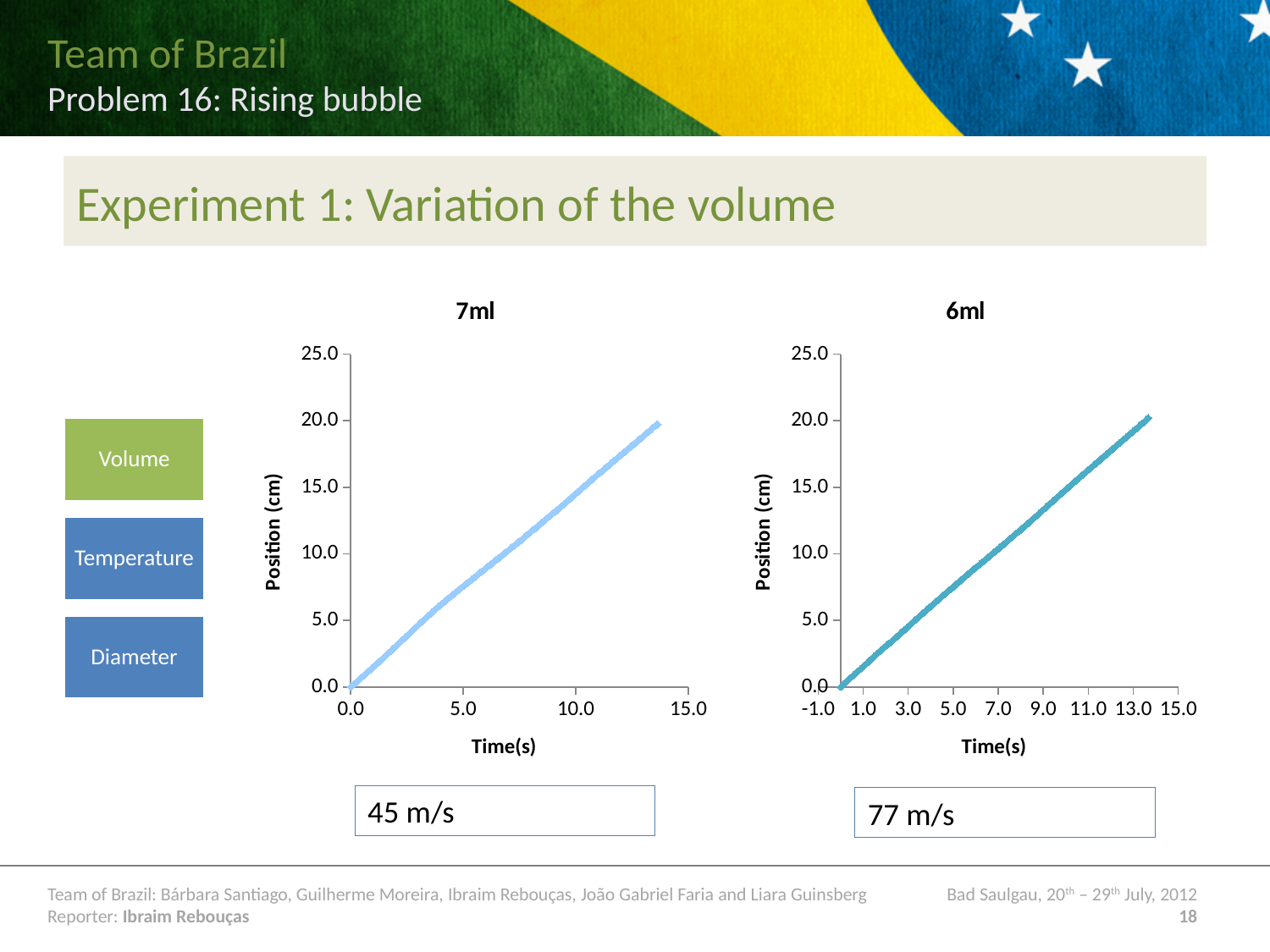
What kind of chart is the chart titled 7ml? line chart What is the label of the vertical axis on the chart titled 7ml? Position (cm) What is the label of the horizontal axis on the chart titled 6ml? Time(s) In the chart titled 7ml, is the highest plotted position greater or less than 25.0 cm? less In the chart titled 7ml, is the position at a time of 5.0 s greater or less than 5.0 cm? greater In the chart titled 7ml, is the position at a time of 5.0 s greater or less than 10.0 cm? less In the chart titled 6ml, does the position rise or fall as time increases? rise In the chart titled 7ml, does the position rise or fall along the time axis? rise